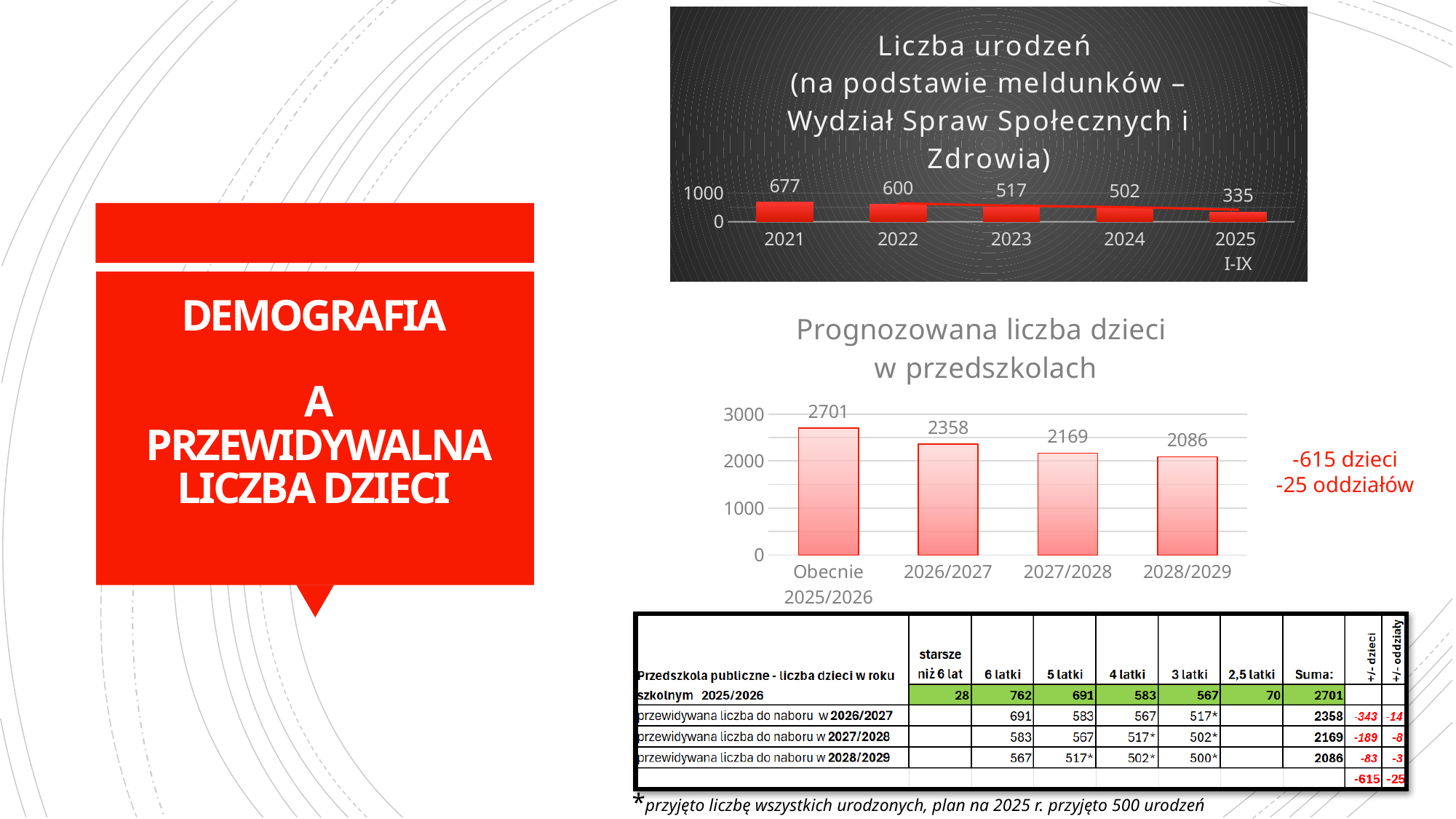
In the 'Prognozowana liczba dzieci w przedszkolach' chart, is the value for 2028/2029 greater or less than 2000? greater In the 'Prognozowana liczba dzieci w przedszkolach' chart, what is the difference between the values for Obecnie 2025/2026 and 2028/2029? 615 In the 'Prognozowana liczba dzieci w przedszkolach' chart, which is larger, the value for 2026/2027 or 2028/2029? 2026/2027 In the 'Liczba urodzeń' chart, how many years are plotted? 5 What kind of chart is the 'Prognozowana liczba dzieci w przedszkolach' chart? bar chart In the 'Prognozowana liczba dzieci w przedszkolach' chart, what is the value for 2027/2028? 2169 In the 'Prognozowana liczba dzieci w przedszkolach' chart, which category has the highest value? Obecnie 2025/2026 In the 'Liczba urodzeń' chart, do the values rise or fall from 2021 to 2025? fall In the 'Liczba urodzeń' chart, which year has the lowest value? 2025 I-IX In the 'Liczba urodzeń' chart, what is the difference between the values for 2021 and 2022? 77 In the 'Liczba urodzeń' chart, what is the value for 2023? 517 In the 'Liczba urodzeń' chart, what is the value for 2021? 677